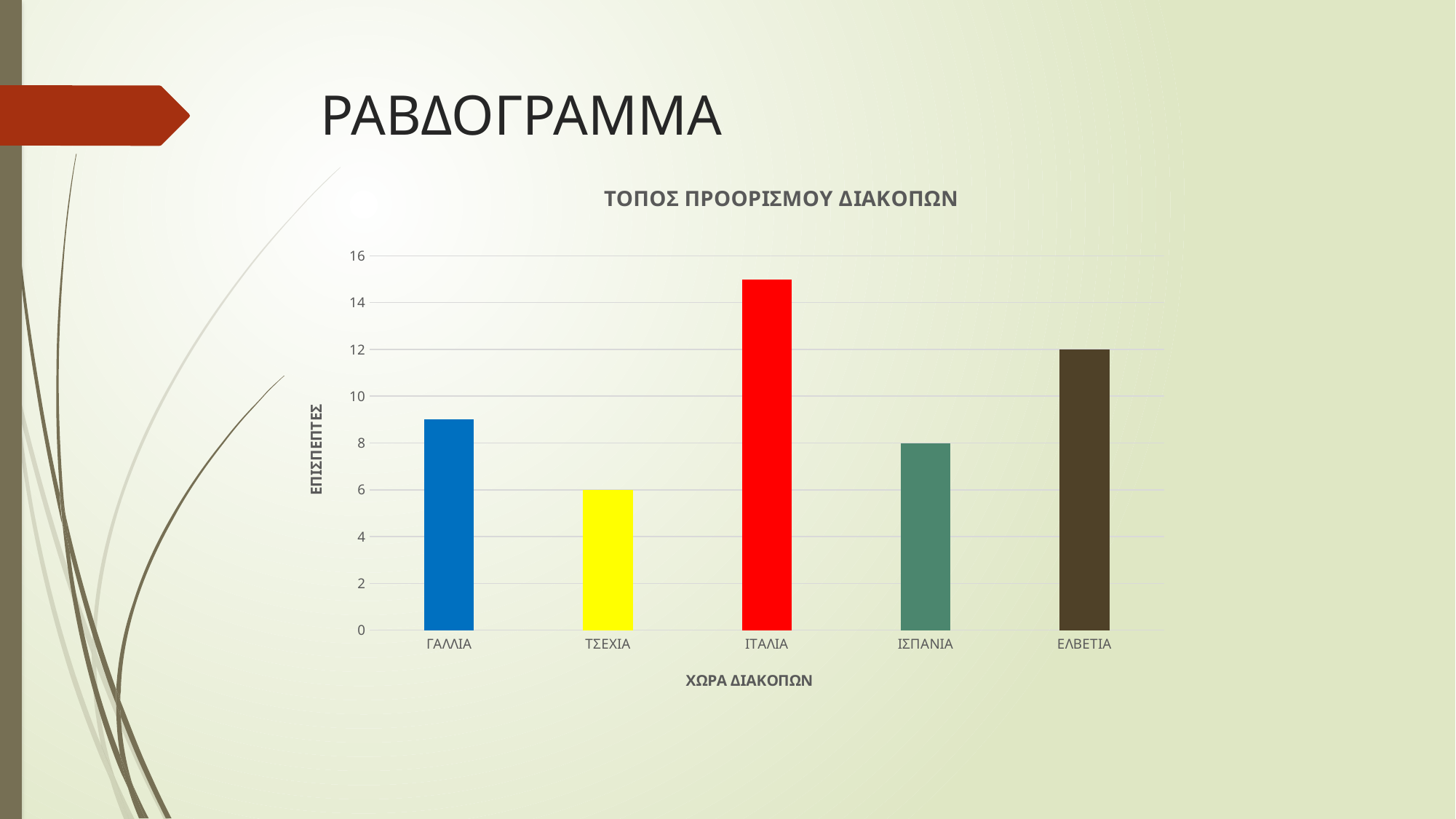
What is the label of the horizontal axis of the chart? ΧΩΡΑ ΔΙΑΚΟΠΩΝ What is the value for ΤΣΕΧΙΑ? 6 What is the difference between the values for ΕΛΒΕΤΙΑ and ΤΣΕΧΙΑ? 6 What kind of chart is shown on the slide? bar chart What is the title of the chart? ΤΟΠΟΣ ΠΡΟΟΡΙΣΜΟΥ ΔΙΑΚΟΠΩΝ Which country has the highest bar? ΙΤΑΛΙΑ How many countries are shown on the chart? 5 Which country has the lowest bar? ΤΣΕΧΙΑ What is the value for ΕΛΒΕΤΙΑ? 12 Which is larger, the value for ΕΛΒΕΤΙΑ or the value for ΓΑΛΛΙΑ? ΕΛΒΕΤΙΑ Is the value for ΙΤΑΛΙΑ greater or less than 12? greater What is the value for ΙΣΠΑΝΙΑ? 8